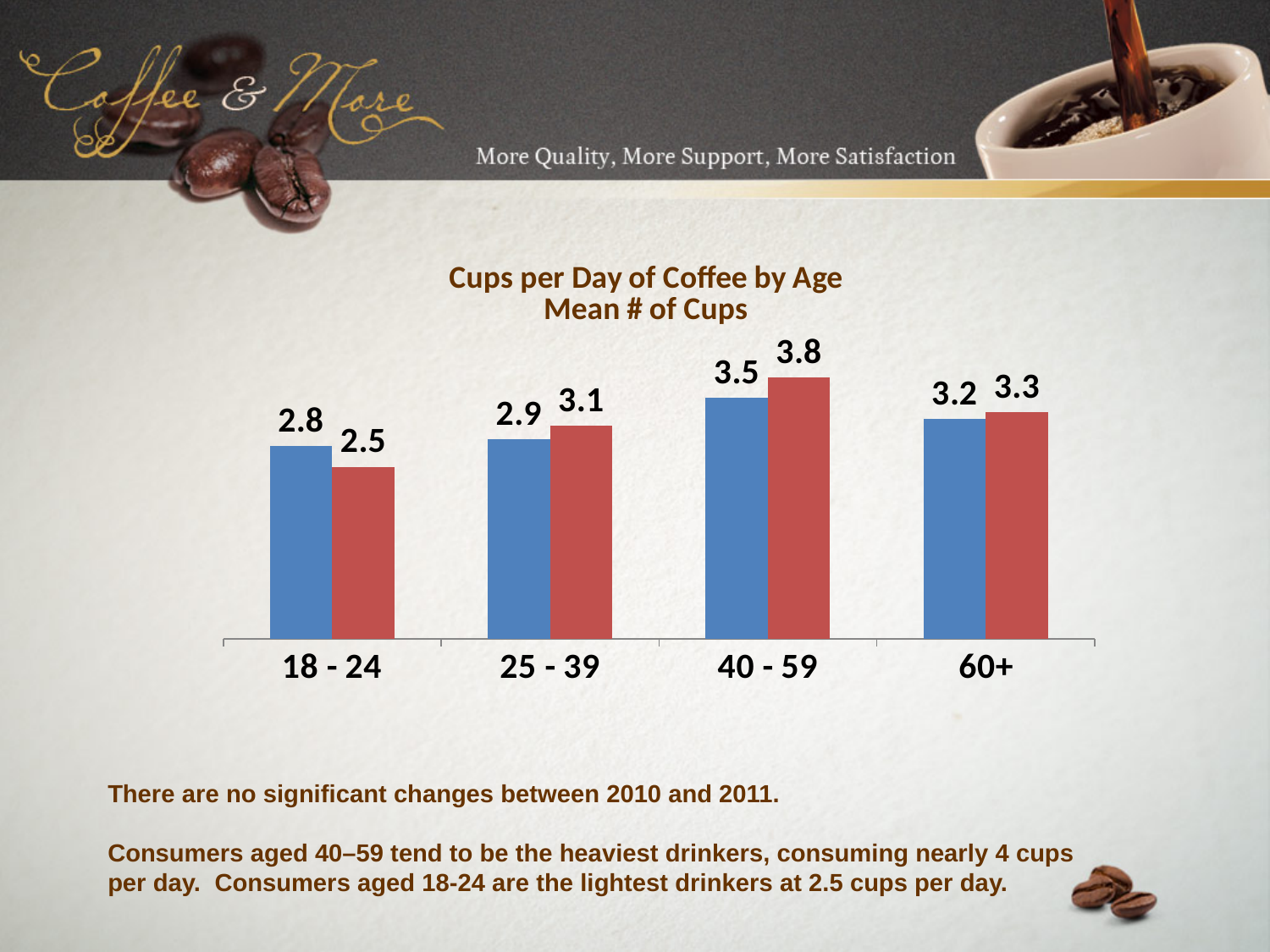
What is the value of the blue bar for the 18 - 24 age group? 2.8 What is the value of the blue bar for the 60+ age group? 3.2 How many age groups are shown on the x axis? 4 Which age group has the highest red bar? 40 - 59 What is the difference between the blue bar for 40 - 59 and the blue bar for 18 - 24? 0.7 What is the title of the chart? Cups per Day of Coffee by Age Mean # of Cups What is the difference between the red and blue bars for the 40 - 59 age group? 0.3 What kind of chart is shown on the slide? bar chart For the 18 - 24 age group, which bar is larger, the blue or the red? blue Which age group has the lowest red bar? 18 - 24 What is the value of the red bar for the 25 - 39 age group? 3.1 What is the value of the red bar for the 40 - 59 age group? 3.8